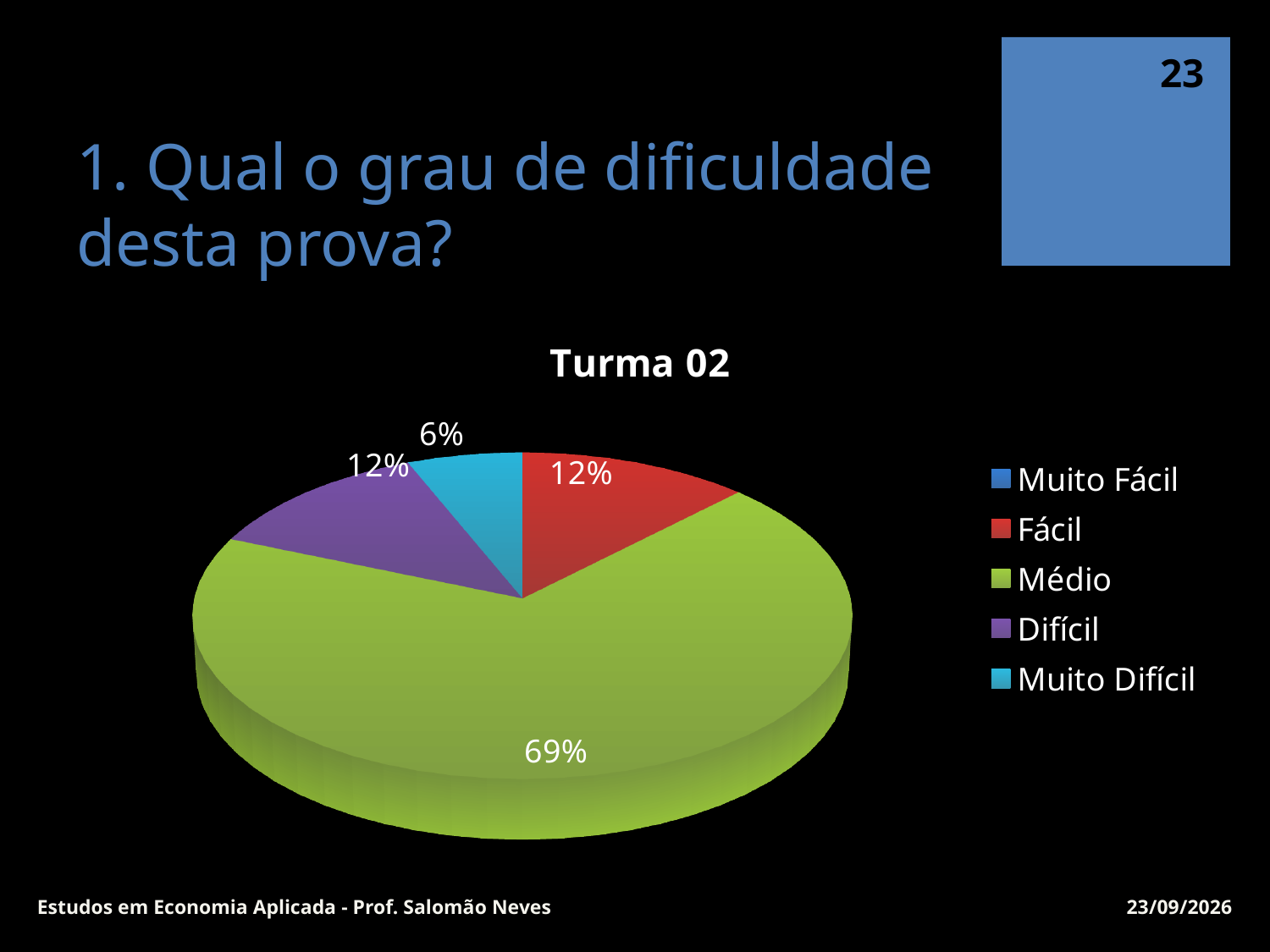
What percentage of the pie corresponds to Difícil? 12% What percentage of the pie corresponds to Muito Difícil? 6% What percentage of the pie corresponds to Fácil? 12% What kind of chart is shown on the slide? pie chart Which of the labelled slices has the smallest share of the pie? Muito Difícil Which category has the largest share of the pie? Médio What percentage of the pie corresponds to Médio? 69% What colour is the Médio slice? green What is the difference in percentage points between the Médio share and the Fácil share? 57 Which is larger, the share for Médio or the share for Difícil? Médio What is the title of the chart? Turma 02 How many categories does the legend list? 5